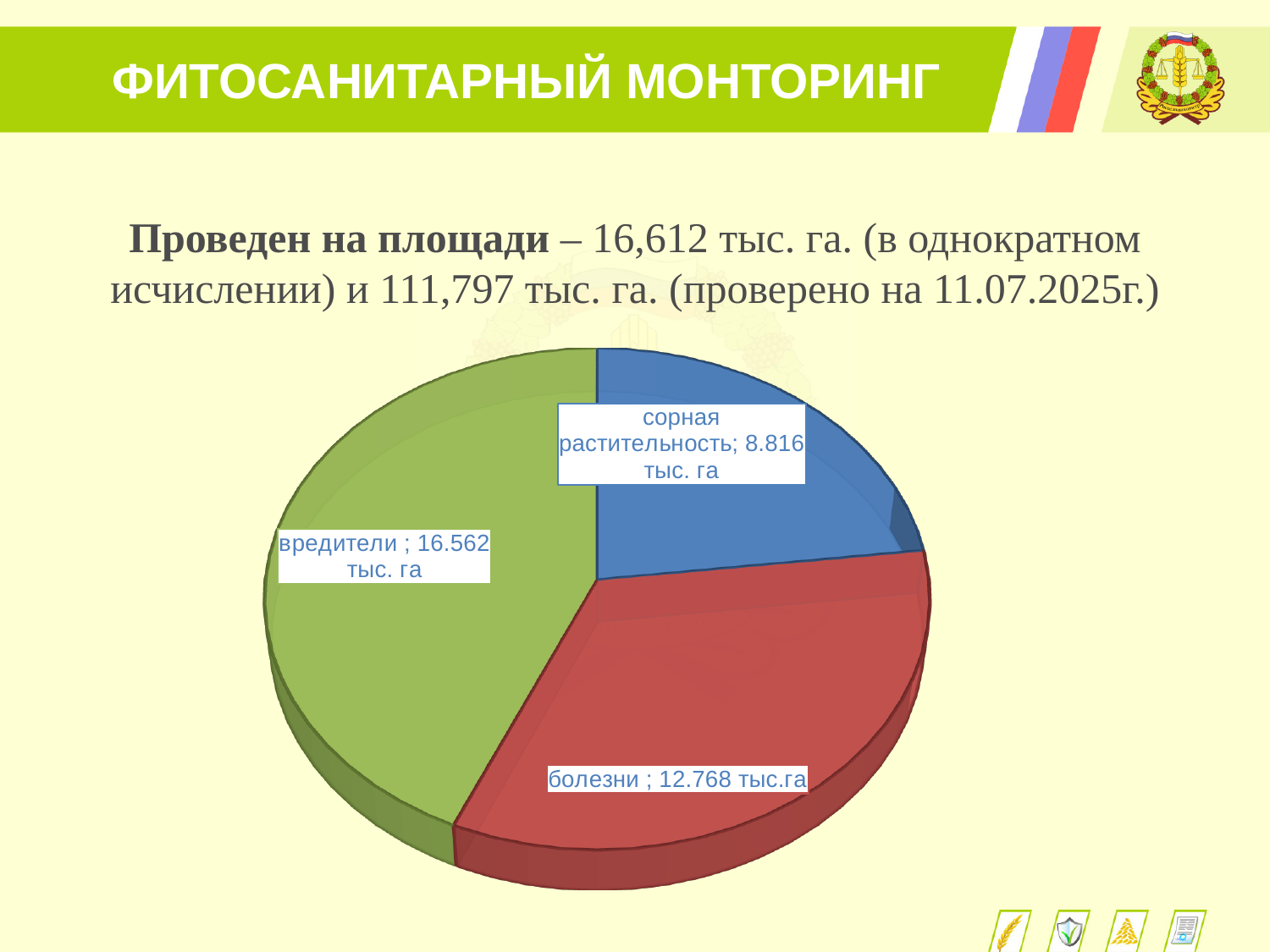
What is the value for вредители in the pie chart? 16.562 тыс. га What is the difference between the values for болезни and сорная растительность? 3.952 тыс. га What is the difference between the values for вредители and болезни? 3.794 тыс. га What is the value for болезни in the pie chart? 12.768 тыс.га How many slices does the pie chart have? 3 What kind of chart is shown on the slide? pie chart Which category has the largest slice in the pie chart? вредители What is the total of all three slices in the pie chart? 38.146 тыс. га What is the value for сорная растительность in the pie chart? 8.816 тыс. га Which is larger, the value for болезни or the value for сорная растительность? болезни Which category has the smallest slice in the pie chart? сорная растительность What colour is the slice for вредители in the pie chart? green